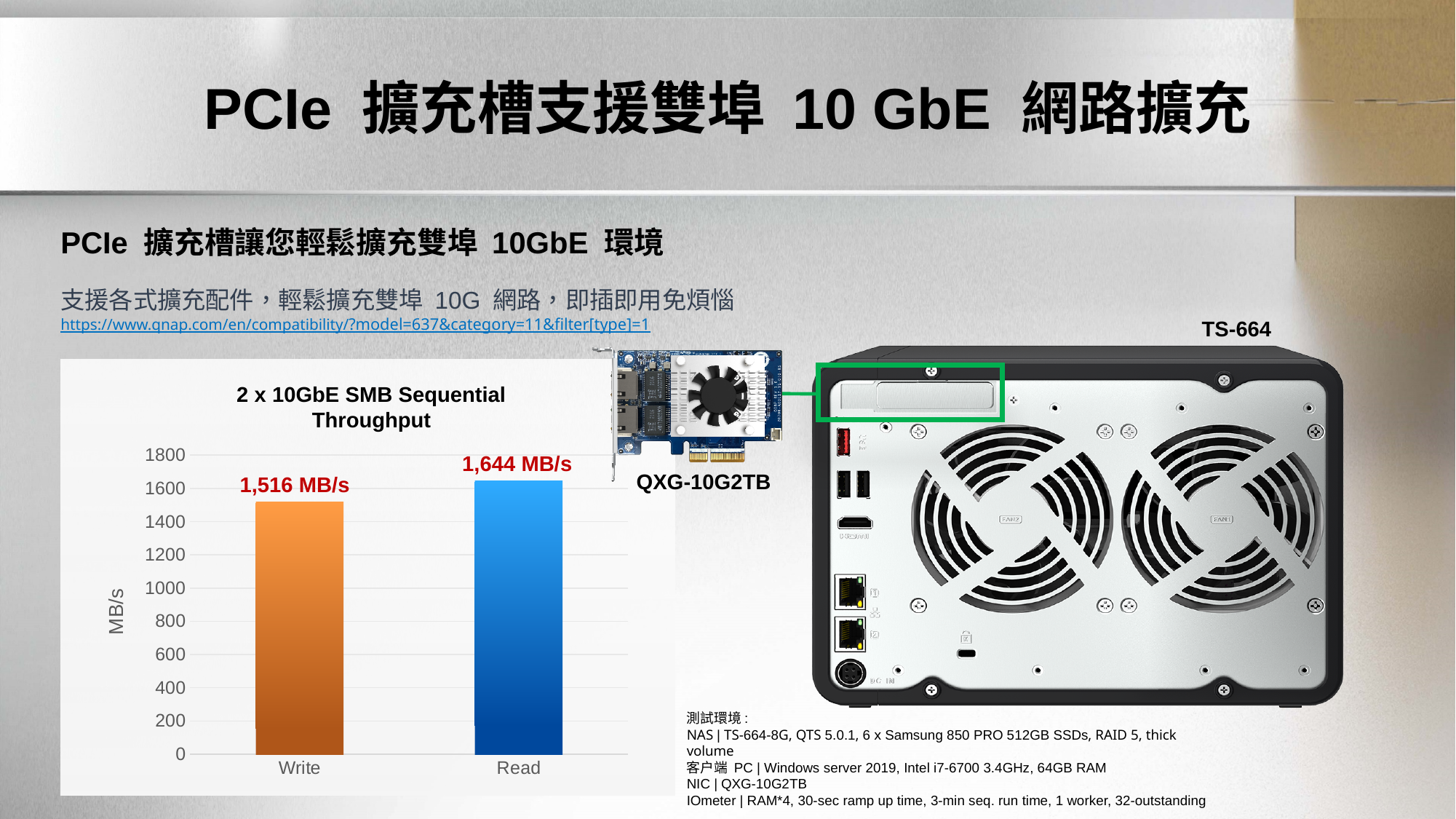
What is the label on the vertical axis of the chart? MB/s Which category has the higher throughput, Write or Read? Read Is the Read throughput greater or less than 1600? greater What is the title of the chart? 2 x 10GbE SMB Sequential Throughput How many categories are plotted in the chart? 2 What kind of chart is shown on the slide? bar chart Which category has the lower throughput in the chart? Write Is the Write throughput greater or less than 1600? less What is the Read throughput shown in the chart? 1,644 MB/s What is the Write throughput shown in the chart? 1,516 MB/s What is the maximum value shown on the vertical axis of the chart? 1800 What is the difference between the Read and Write throughput values? 128 MB/s